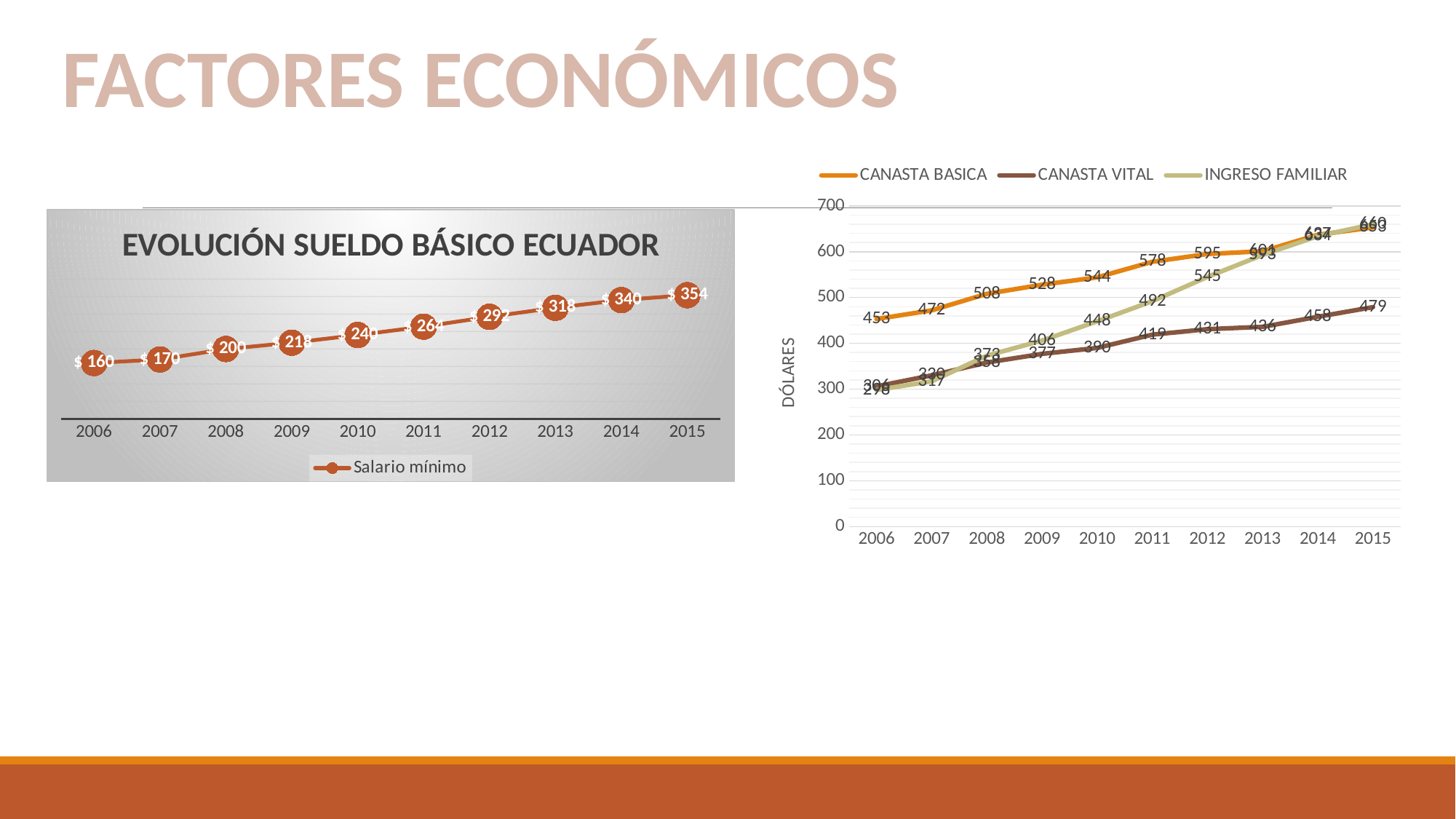
In the chart on the right, how many series does the legend list? 3 In the chart titled EVOLUCIÓN SUELDO BÁSICO ECUADOR, how many years are shown on the x axis? 10 In the chart on the right, which is larger in 2010: CANASTA BASICA or CANASTA VITAL? CANASTA BASICA In the chart titled EVOLUCIÓN SUELDO BÁSICO ECUADOR, what is the difference between the Salario mínimo values for 2014 and 2013? $ 22 In the chart titled EVOLUCIÓN SUELDO BÁSICO ECUADOR, does the Salario mínimo rise or fall from 2006 to 2015? rise In the chart on the right, what is the INGRESO FAMILIAR value for 2012? 545 In the chart titled EVOLUCIÓN SUELDO BÁSICO ECUADOR, what is the Salario mínimo value for 2015? $ 354 In the chart on the right, what is the CANASTA BASICA value for 2006? 453 In the chart on the right, what is the difference between CANASTA BASICA and CANASTA VITAL in 2011? 159 In the chart on the right, what is the CANASTA VITAL value for 2015? 479 In the chart titled EVOLUCIÓN SUELDO BÁSICO ECUADOR, what is the Salario mínimo value for 2006? $ 160 In the chart titled EVOLUCIÓN SUELDO BÁSICO ECUADOR, which year has the lowest Salario mínimo? 2006